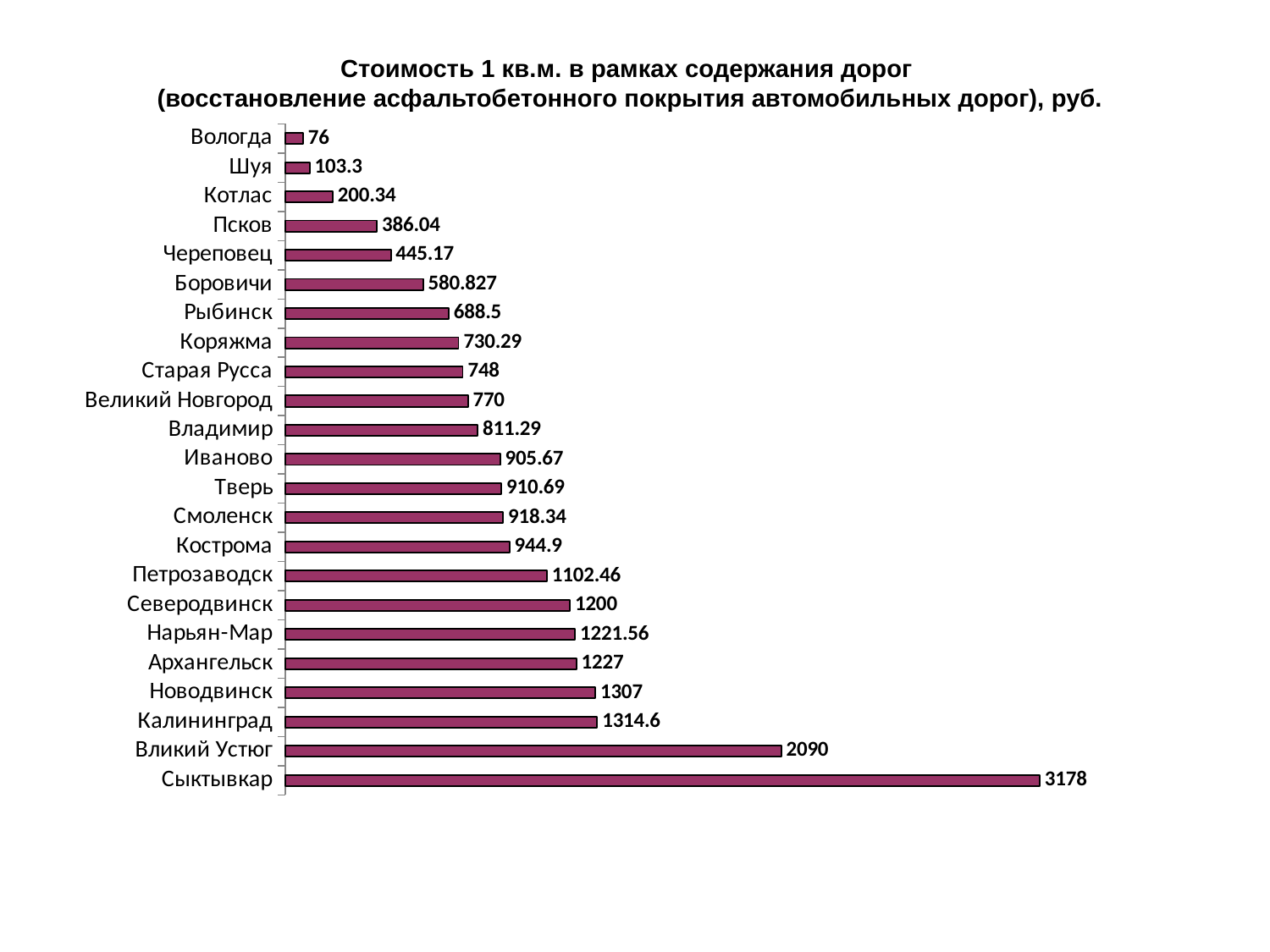
What is the value for Петрозаводск? 1102.46 What is the value for Сыктывкар? 3178 What unit is given in the chart title? руб. What is the value for Череповец? 445.17 What is the difference between the values for Котлас and Вологда? 124.34 Which city has the highest value? Сыктывкар How many cities are shown in the chart? 23 Which city has the lowest value? Вологда What is the difference between the values for Сыктывкар and Вликий Устюг? 1088 What kind of chart is shown on the slide? Bar chart What is the value for Боровичи? 580.827 Which is larger, the value for Калининград or the value for Новодвинск? Калининград